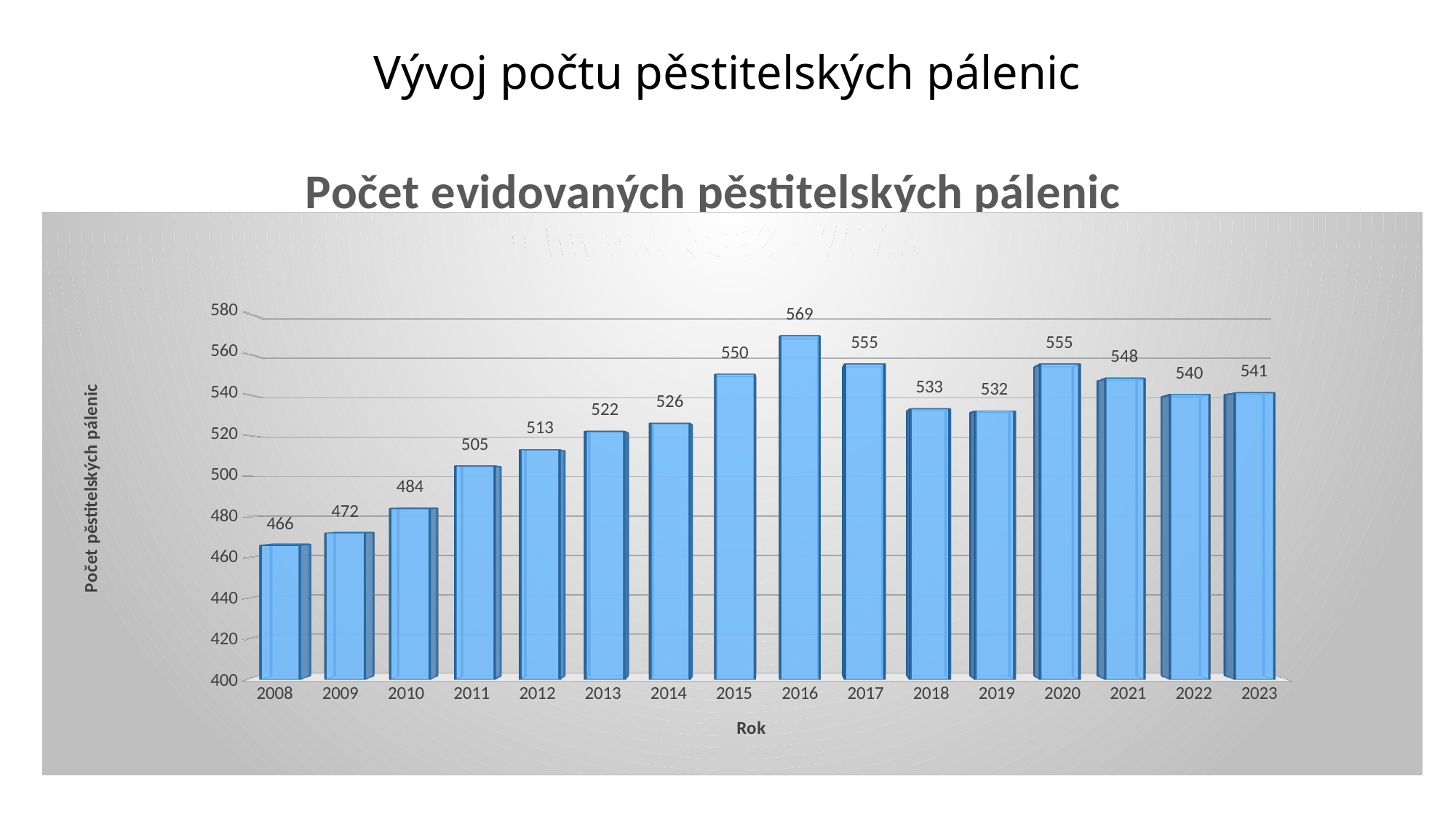
How many years are shown on the x axis? 16 What kind of chart is shown? bar chart Is the value for 2014 greater or less than 520? greater What is the difference between the values for 2023 and 2022? 1 What is the value for 2008? 466 Which year has the highest value? 2016 Which year has the lowest value? 2008 What is the value for 2021? 548 Which is larger, the value for 2015 or the value for 2018? 2015 What is the difference between the values for 2016 and 2008? 103 What is the title of the chart? Počet evidovaných pěstitelských pálenic What is the value for 2016? 569